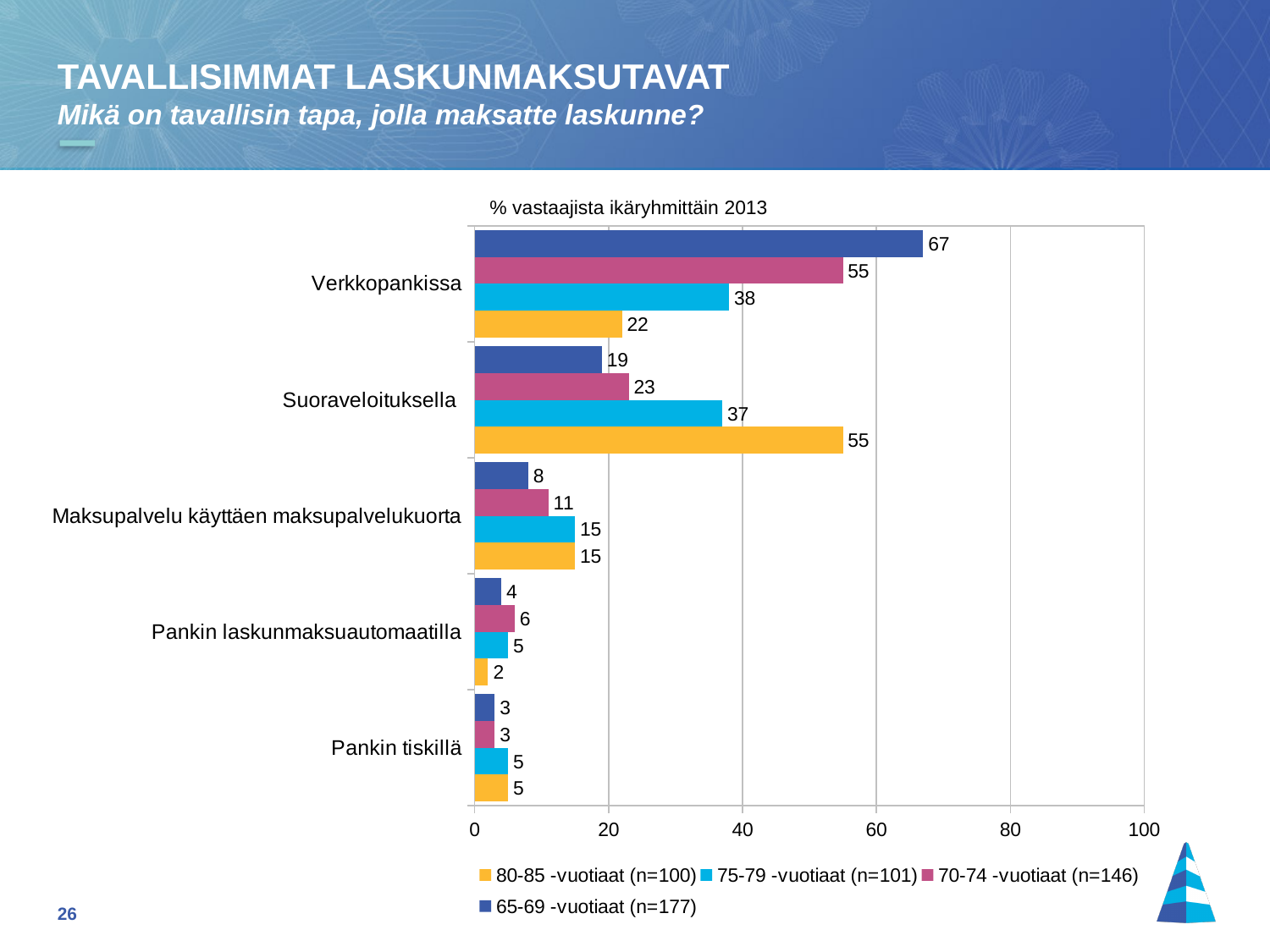
What is the value for 70-74 -vuotiaat (n=146) for Pankin laskunmaksuautomaatilla? 6 Which category has the lowest value for 80-85 -vuotiaat (n=100)? Pankin laskunmaksuautomaatilla Which category has the highest value for 65-69 -vuotiaat (n=177)? Verkkopankissa What is the value for 80-85 -vuotiaat (n=100) for Suoraveloituksella? 55 What is the difference between the 65-69 -vuotiaat and 80-85 -vuotiaat values for Verkkopankissa? 45 What is the value for 65-69 -vuotiaat (n=177) for Verkkopankissa? 67 How many series does the legend list? 4 What is the value for 75-79 -vuotiaat (n=101) for Maksupalvelu käyttäen maksupalvelukuorta? 15 For Suoraveloituksella, which is larger: the value for 75-79 -vuotiaat or the value for 70-74 -vuotiaat? 75-79 -vuotiaat What is the title shown above the chart? % vastaajista ikäryhmittäin 2013 How many categories are shown on the chart? 5 What kind of chart is shown on the slide? Bar chart